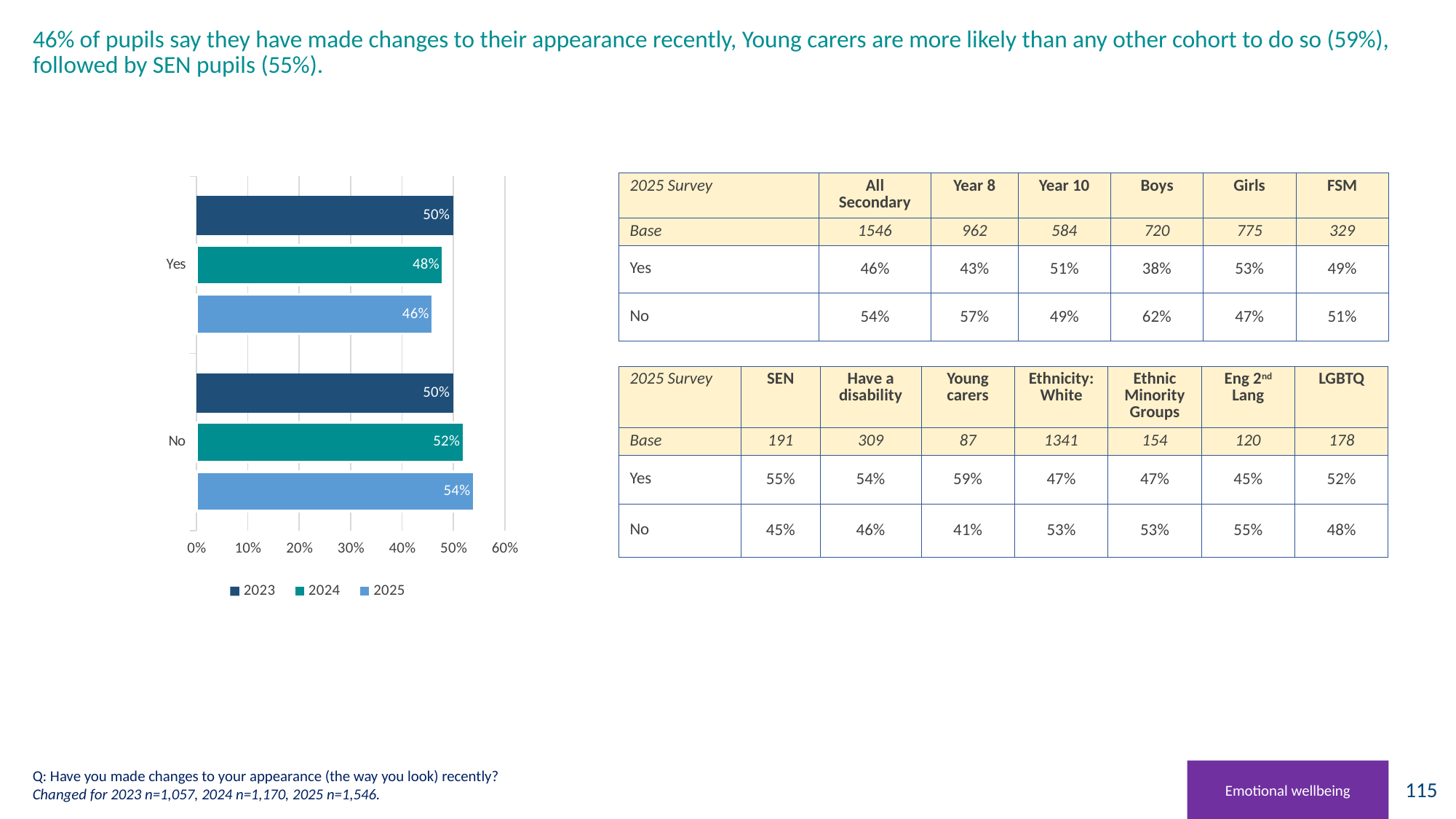
How many series does the legend list? 3 Which year has the lowest value for Yes? 2025 How many categories are shown on the chart? 2 Which year has the highest value for No? 2025 Does the value for Yes go up or down from 2023 to 2025? down Which is larger, the Yes value in 2024 or the No value in 2024? No in 2024 What is the difference between the No value in 2025 and the Yes value in 2025? 8% What is the value for Yes in 2023? 50% What are the three series listed in the legend? 2023, 2024, 2025 What kind of chart is shown on the slide? bar chart What is the value for Yes in 2025? 46% What is the value for No in 2024? 52%